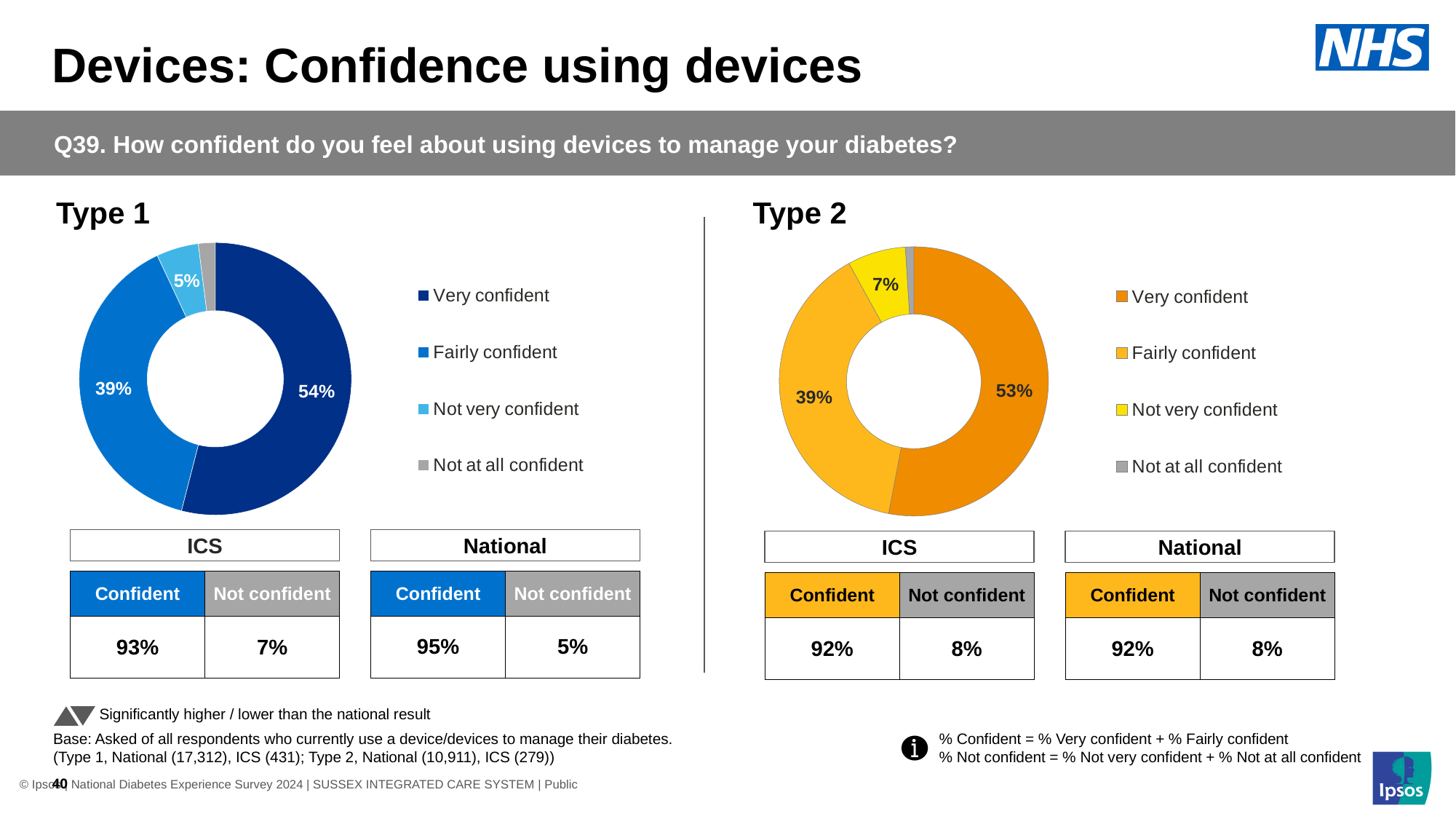
In the Type 2 chart, what colour is the Not very confident segment? Yellow In the Type 2 chart, which category has the smallest share? Not at all confident In the Type 1 chart, what percentage of respondents are very confident? 54% How many categories does the legend of the Type 2 chart list? 4 In the Type 1 chart, what is the difference between the very confident and fairly confident shares? 15% In the Type 2 chart, what percentage of respondents are not very confident? 7% In the Type 2 chart, which is larger: the very confident share or the fairly confident share? Very confident In the Type 1 chart, what colour is the Very confident segment? Dark blue What kind of chart is used for Type 1? Donut chart In the Type 1 chart, which category has the largest share? Very confident In the Type 2 chart, what percentage of respondents are fairly confident? 39% In the Type 1 chart, what percentage of respondents are not very confident? 5%